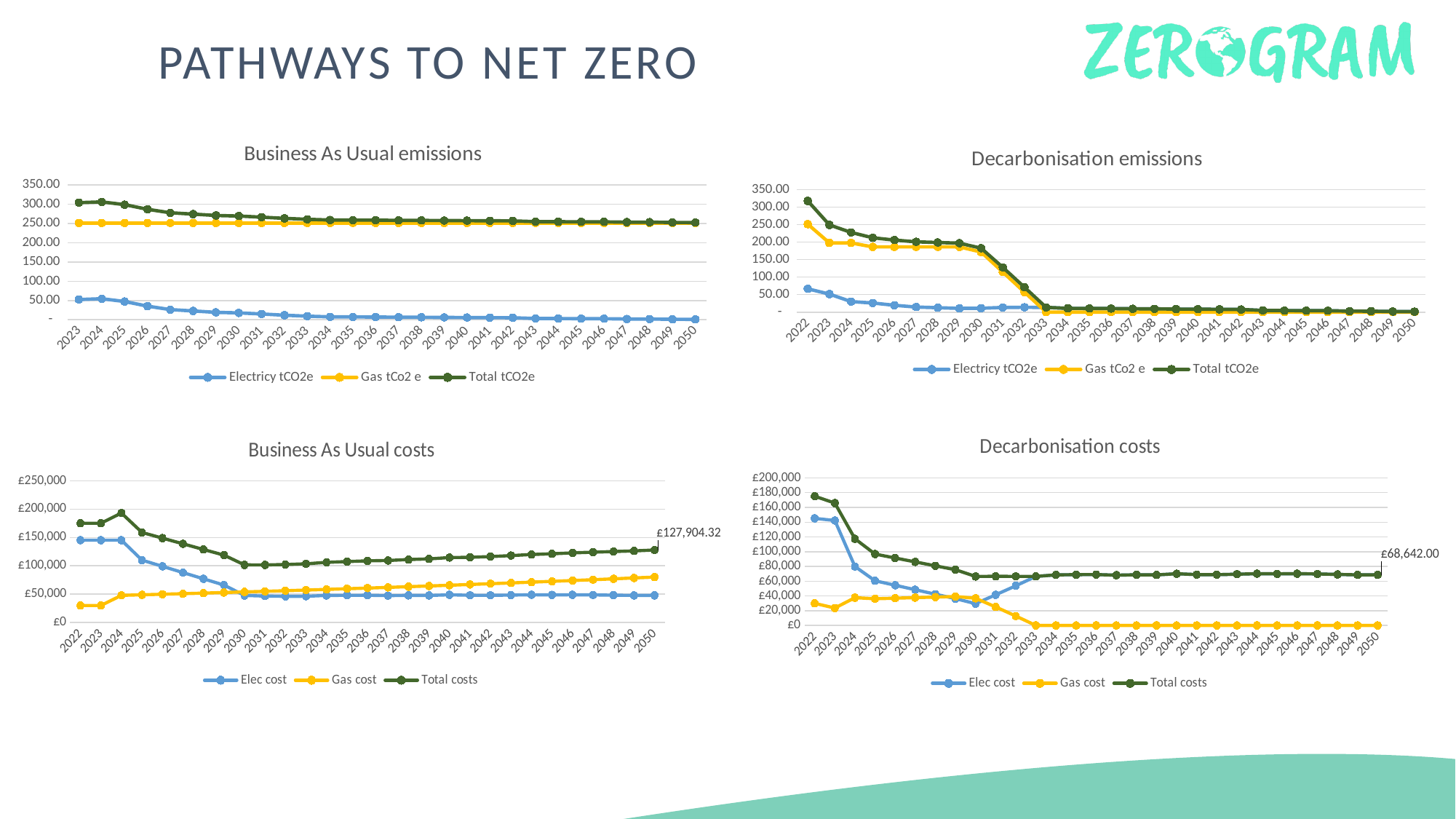
What kind of chart is the Decarbonisation emissions chart? Line chart What is the difference between the labelled 2050 Total costs in the Business As Usual costs chart and in the Decarbonisation costs chart? £59,262.32 What are the three legend entries of the Decarbonisation costs chart? Elec cost, Gas cost, Total costs How many series does the legend of the Business As Usual emissions chart list? 3 Which chart shows the larger labelled Total costs value for 2050: Business As Usual costs or Decarbonisation costs? Business As Usual costs In the Decarbonisation emissions chart, does the Total tCO2e series rise or fall from 2022 to 2050? Fall How many years are shown on the x axis of the Business As Usual emissions chart? 28 In the Business As Usual emissions chart, is the value for Gas tCo2 e in 2023 greater or less than 200.00? greater In the Decarbonisation emissions chart, in which year is Total tCO2e highest? 2022 In the Decarbonisation costs chart, is the Gas cost in 2040 greater or less than £20,000? less In the Business As Usual costs chart, what is the labelled value of Total costs in 2050? £127,904.32 In the Decarbonisation costs chart, what is the labelled value of Total costs in 2050? £68,642.00